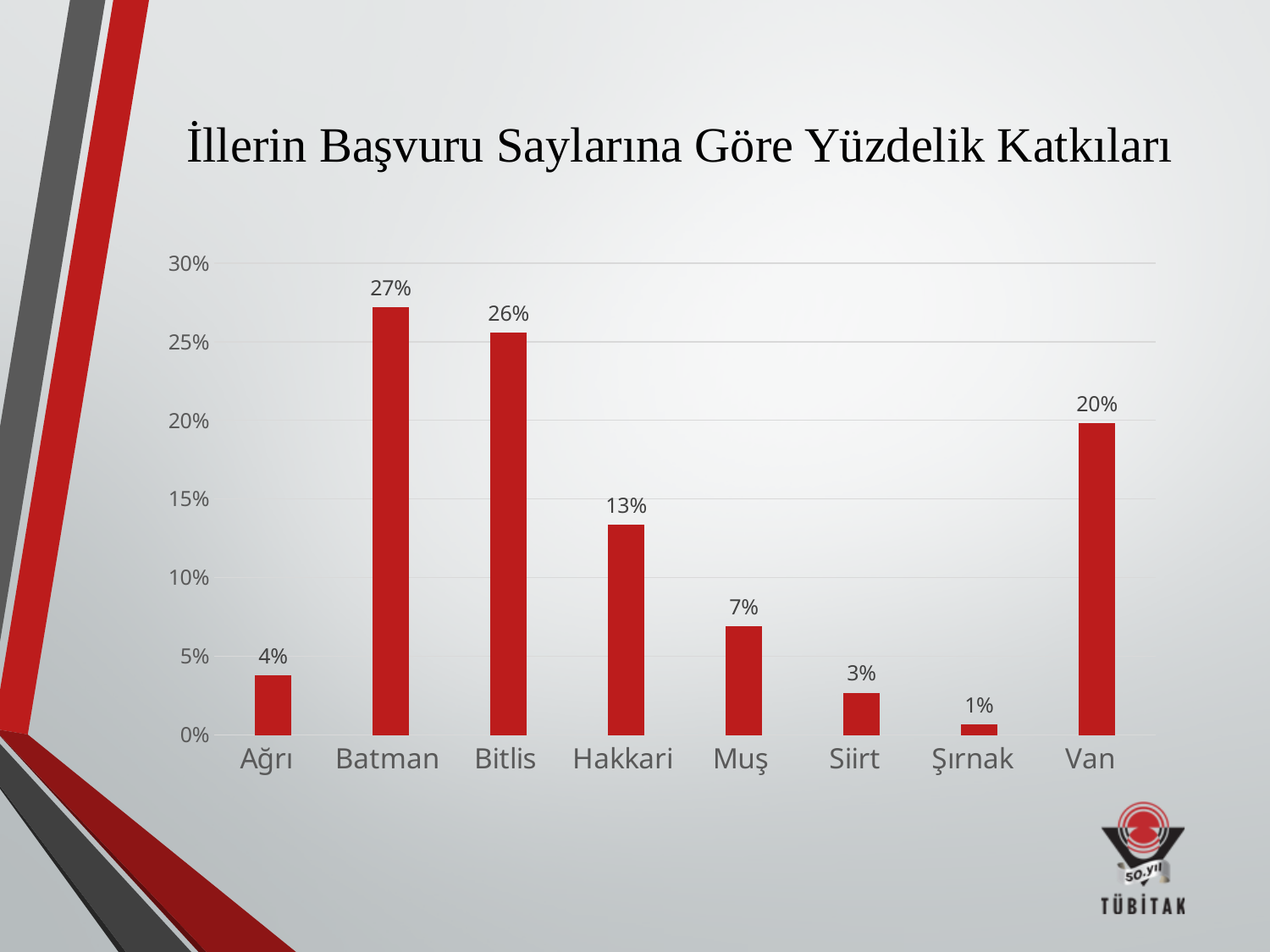
Which province has the highest value? Batman What is the value for Batman? 27% What is the difference between the values for Van and Muş? 13% How many provinces are shown on the x axis? 8 What is the value for Hakkari? 13% What is the value for Van? 20% What is the value for Şırnak? 1% Which is larger, the value for Hakkari or the value for Muş? Hakkari What kind of chart is shown on the slide? Bar chart Which province has the lowest value? Şırnak What is the difference between the values for Batman and Bitlis? 1% Is the value for Van greater or less than 15%? greater